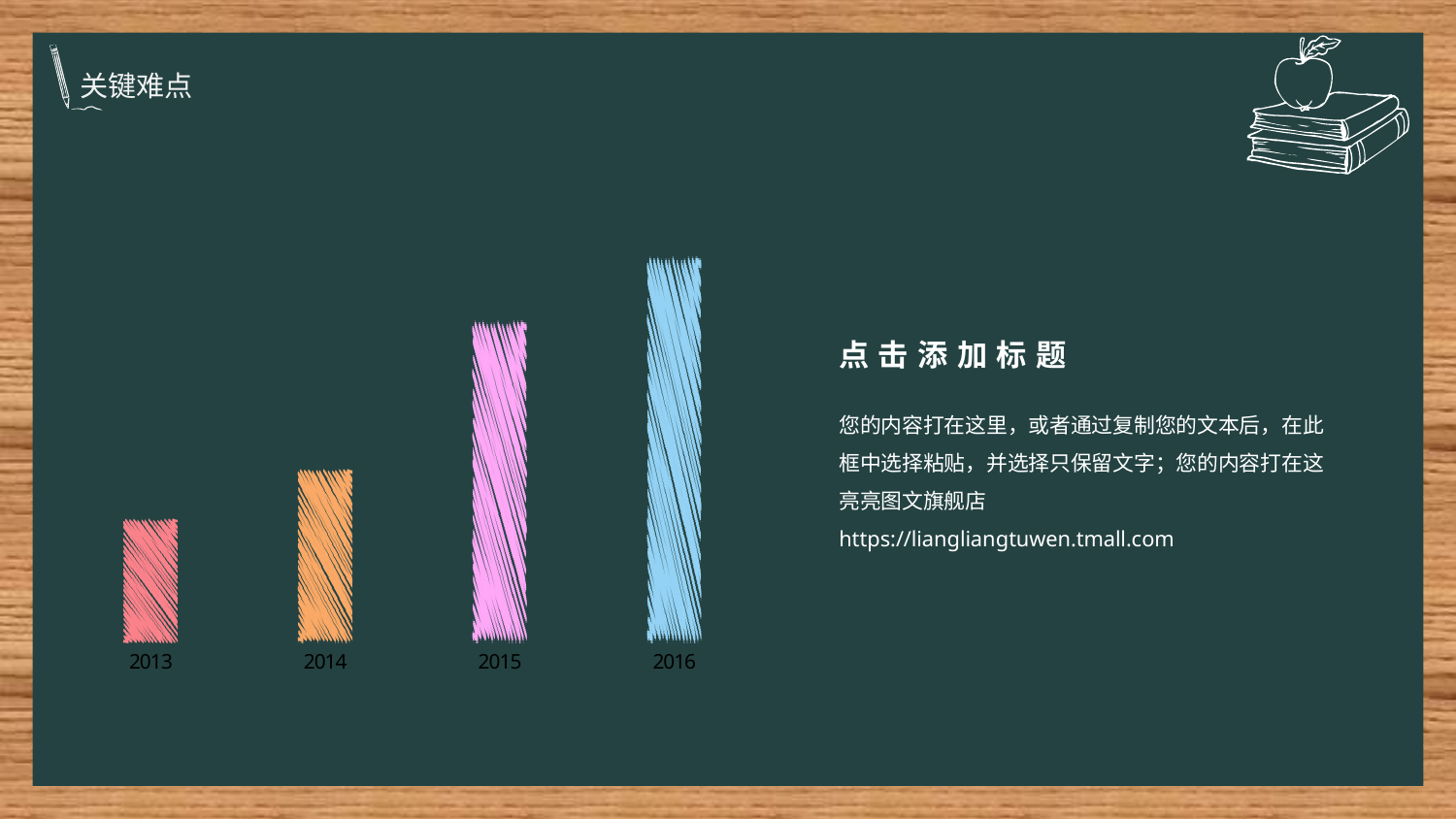
What kind of chart is shown on the slide? bar chart What colour is the bar for 2016? blue What is the first year shown on the x axis of the chart? 2013 Which is larger, the bar for 2013 or the bar for 2014? 2014 Do the bar values rise or fall from 2013 to 2016? rise Which year has the lowest bar in the chart? 2013 Which year has the highest bar in the chart? 2016 How many categories are plotted in the chart? 4 Which is larger, the bar for 2014 or the bar for 2015? 2015